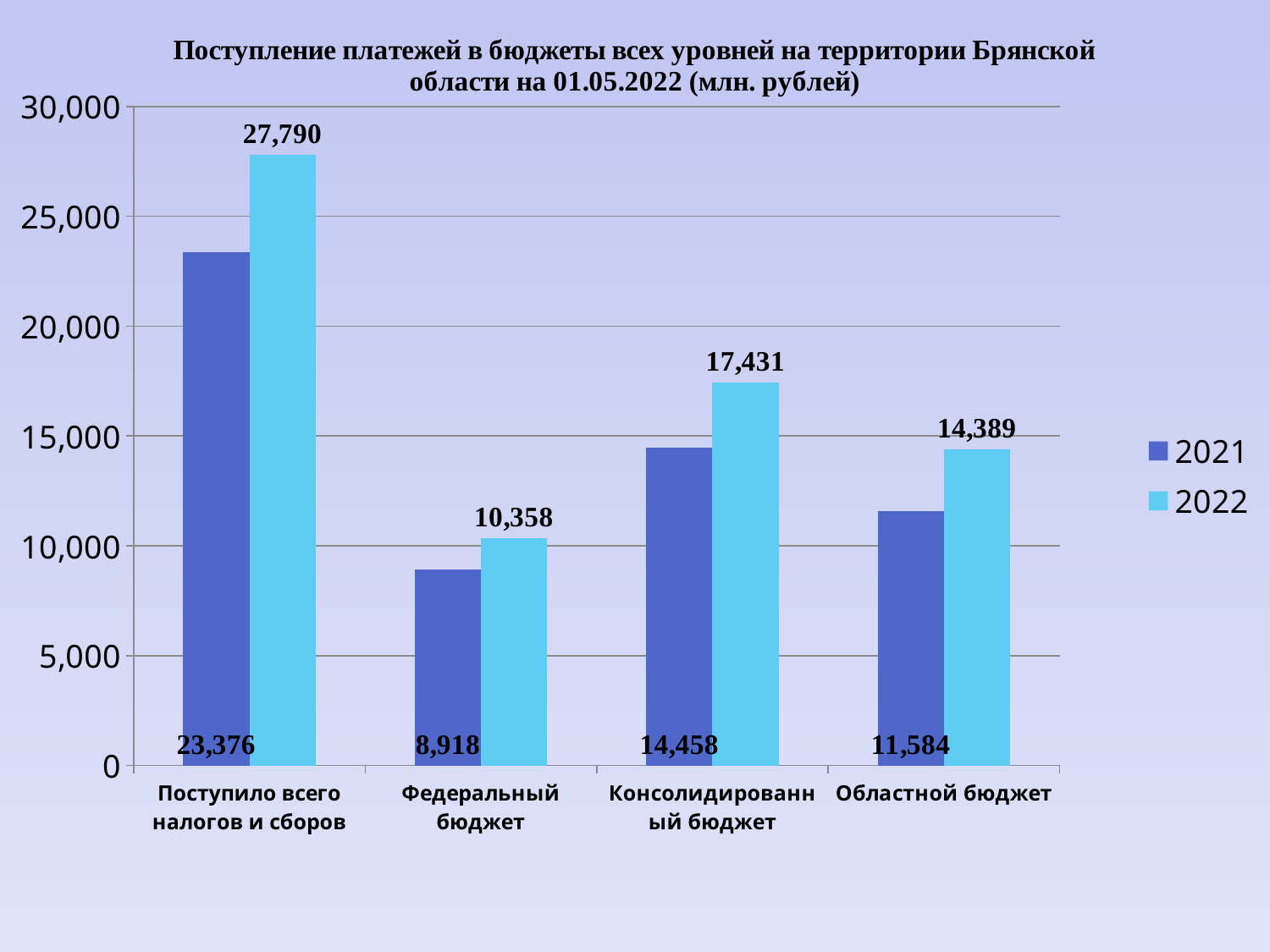
What is the 2021 value for Областной бюджет? 11,584 Which is larger: the 2022 value for Областной бюджет or the 2021 value for Консолидированный бюджет? 2021 value for Консолидированный бюджет How many categories are shown on the x axis? 4 How many series does the legend list? 2 What kind of chart is shown on the slide? Bar chart Which category has the highest 2021 value? Поступило всего налогов и сборов What is the difference between the 2022 and 2021 values for Поступило всего налогов и сборов? 4,414 What is the difference between the 2022 and 2021 values for Консолидированный бюджет? 2,973 What is the 2021 value for Федеральный бюджет? 8,918 Which category has the lowest 2022 value? Федеральный бюджет What is the 2022 value for Консолидированный бюджет? 17,431 What is the 2022 value for Поступило всего налогов и сборов? 27,790